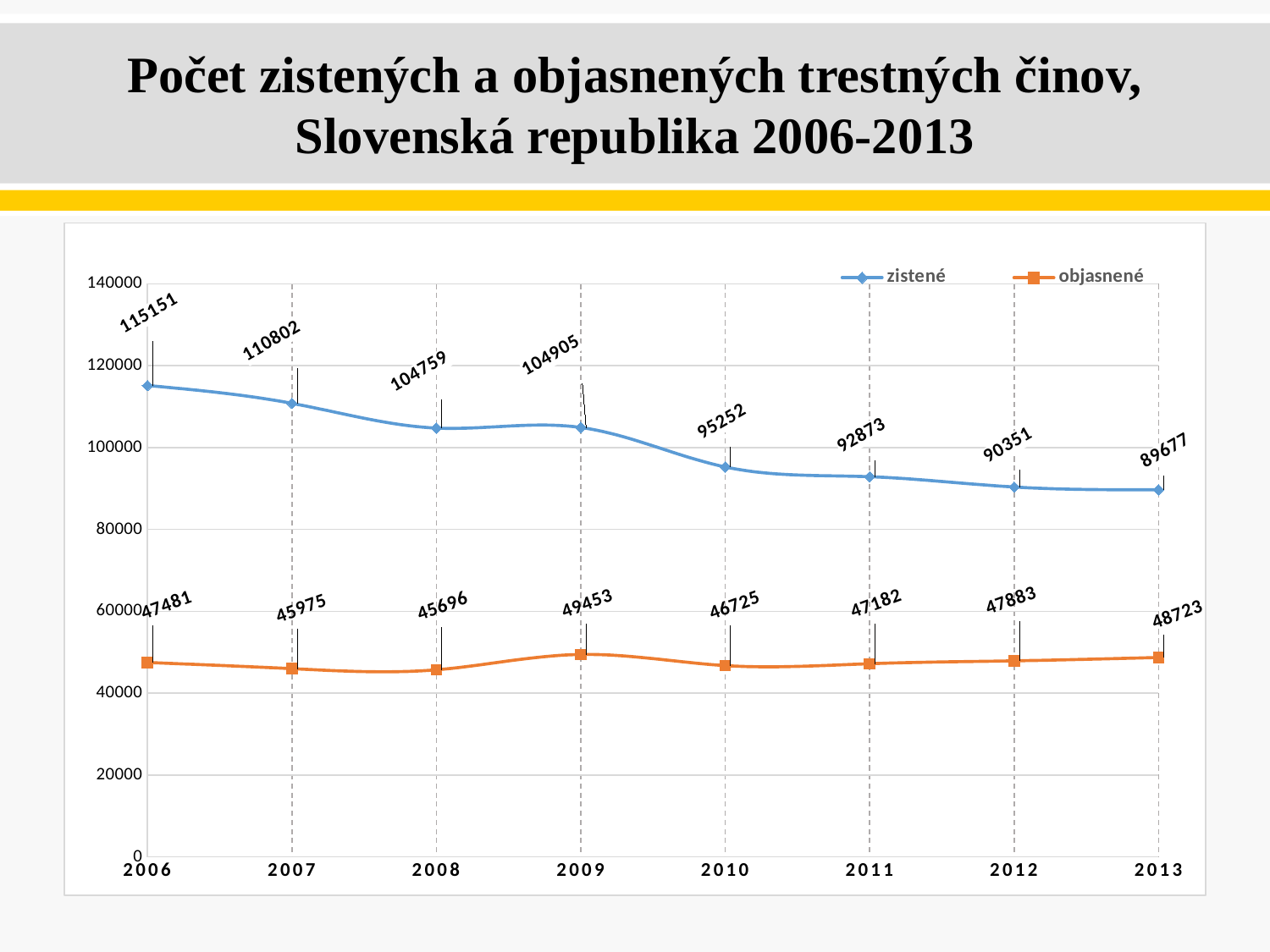
What is the value of zistené in 2010? 95252 Does the zistené series rise or fall from 2006 to 2013? fall What is the value of zistené in 2006? 115151 Is the value of zistené in 2011 greater or less than 100000? less What is the value of objasnené in 2013? 48723 How many series does the legend list? 2 By how much did zistené decrease from 2006 to 2013? 25474 How many years are plotted on the x axis? 8 What is the difference between zistené and objasnené in 2006? 67670 What type of chart is shown on the slide? line chart In which year is the objasnené series highest? 2009 In which year is the zistené series lowest? 2013